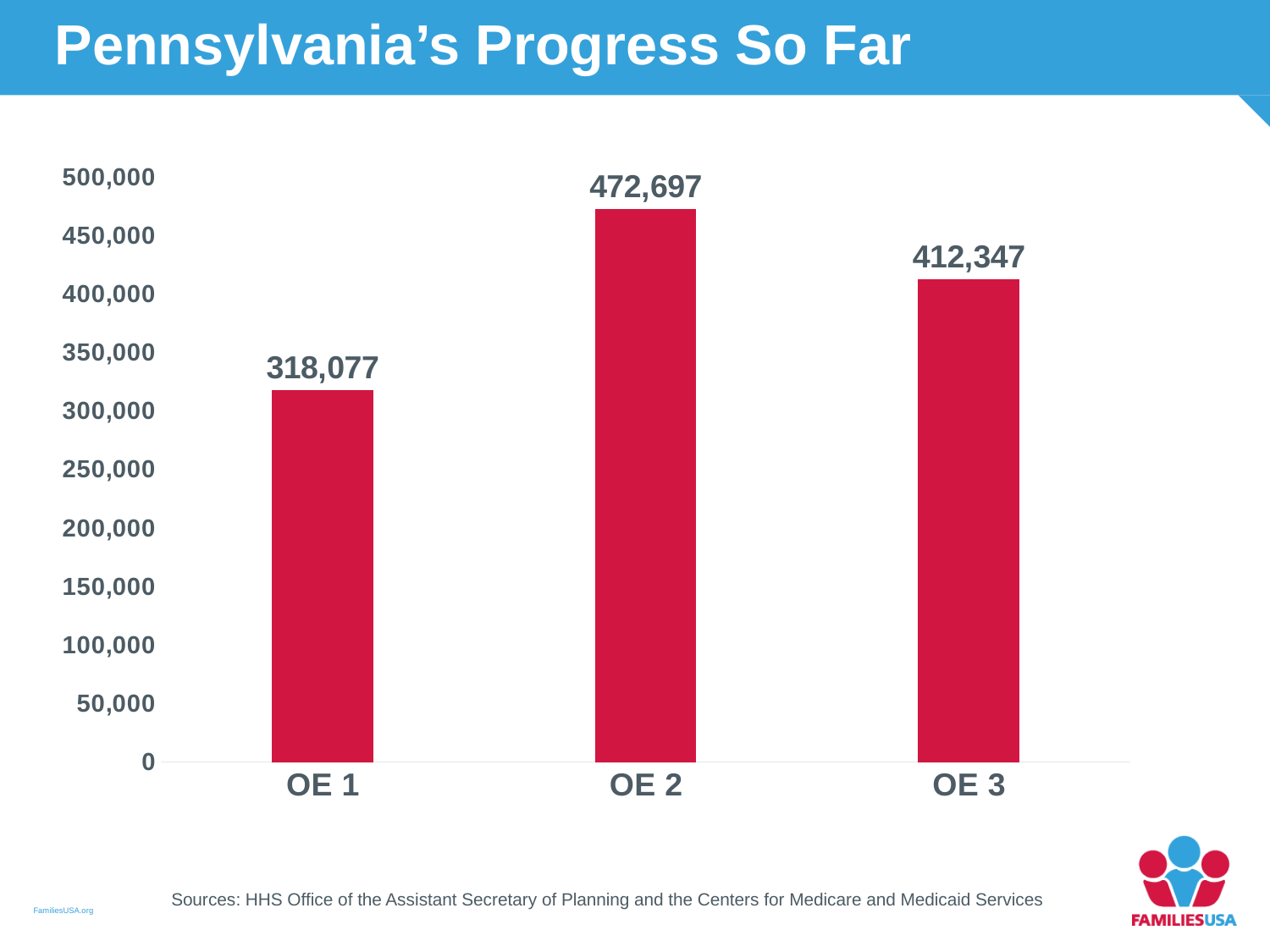
What is the difference between the values for OE 2 and OE 1? 154,620 Is the value for OE 3 greater or less than 400,000? greater Which is larger, the value for OE 1 or the value for OE 3? OE 3 What is the value for OE 2? 472,697 What is the value for OE 3? 412,347 What is the value for OE 1? 318,077 What is the title of the slide containing the chart? Pennsylvania's Progress So Far What is the difference between the values for OE 2 and OE 3? 60,350 How many categories are shown on the x axis? 3 Which category has the lowest value? OE 1 Which category has the highest value? OE 2 What kind of chart is shown on the slide? bar chart